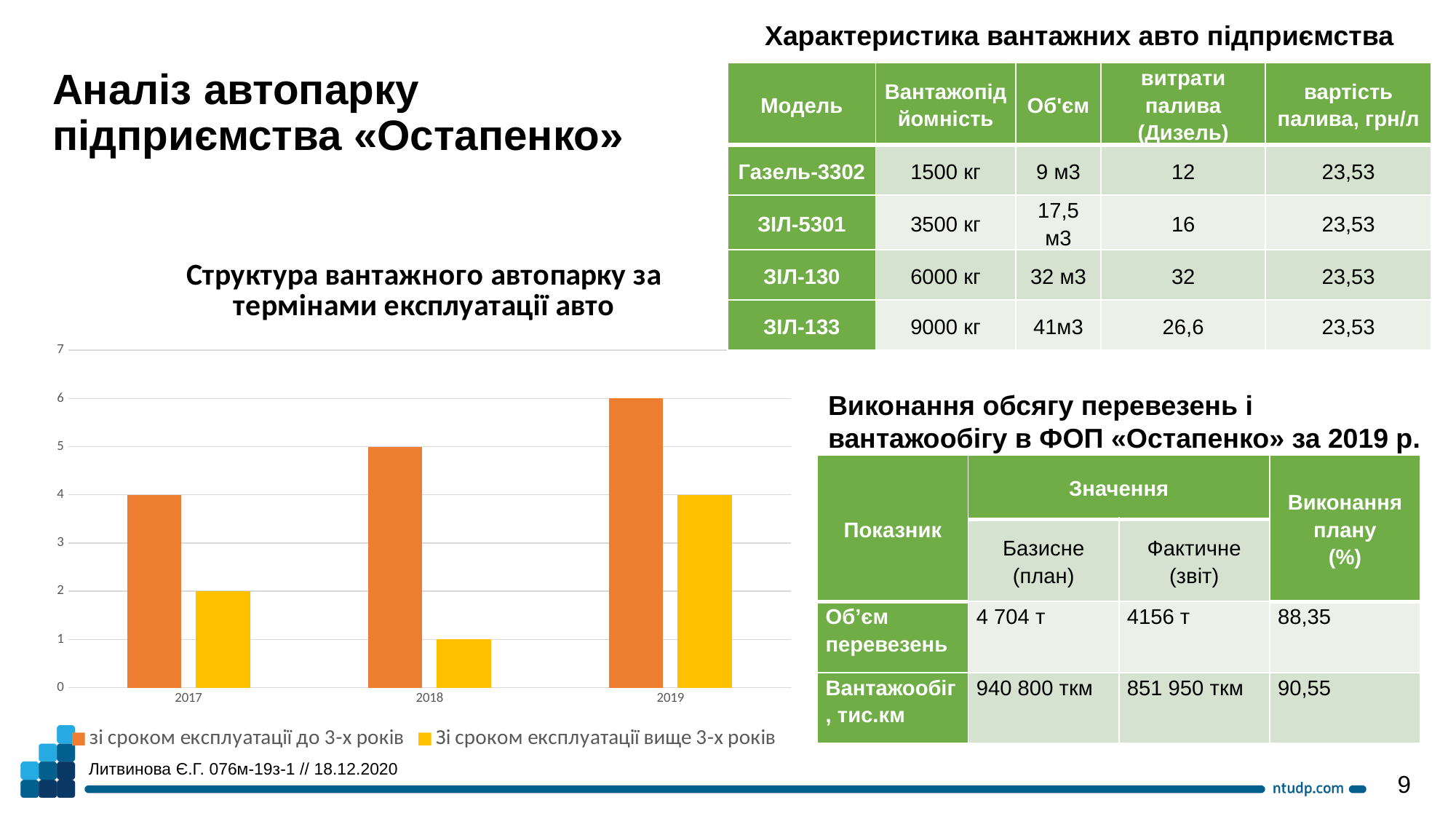
What kind of chart is shown on the slide? bar chart What is the difference between the two series in 2018? 4 What is the title of the chart? Структура вантажного автопарку за термінами експлуатації авто In which year is the value for 'зі сроком експлуатації до 3-х років' highest? 2019 Which series has the larger value in 2017? зі сроком експлуатації до 3-х років Does the value for 'зі сроком експлуатації до 3-х років' rise or fall from 2017 to 2019? rise What is the value for 'зі сроком експлуатації до 3-х років' in 2019? 6 How many years are shown on the x axis of the chart? 3 How many series does the chart legend list? 2 In which year is the value for 'Зі сроком експлуатації вище 3-х років' lowest? 2018 What is the value for 'Зі сроком експлуатації вище 3-х років' in 2018? 1 What is the value for 'зі сроком експлуатації до 3-х років' in 2017? 4